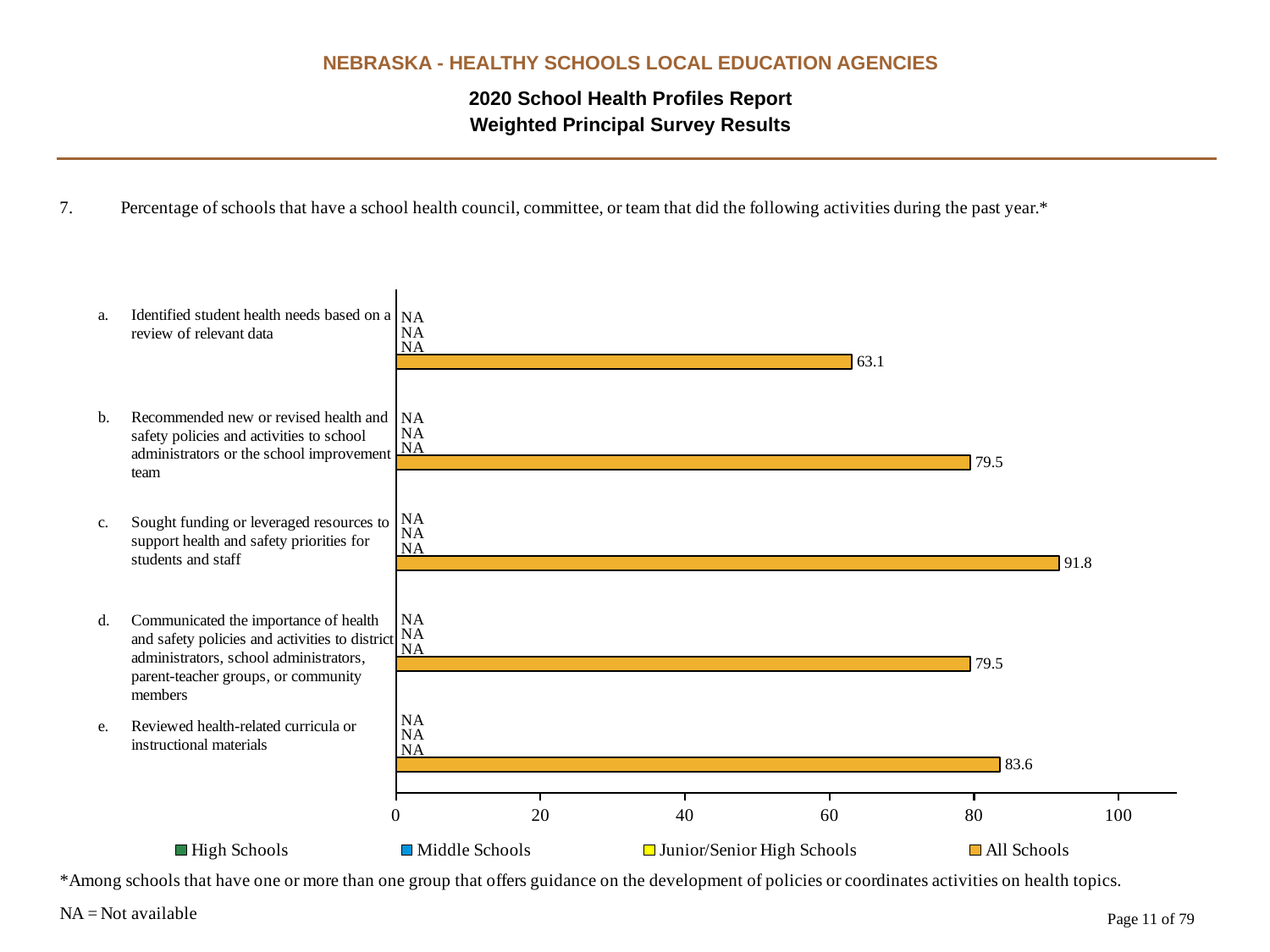
What is the All Schools value for 'Sought funding or leveraged resources to support health and safety priorities for students and staff'? 91.8 Which is larger for All Schools: 'Reviewed health-related curricula or instructional materials' or 'Recommended new or revised health and safety policies and activities to school administrators or the school improvement team'? Reviewed health-related curricula or instructional materials Which activity has the lowest All Schools percentage? Identified student health needs based on a review of relevant data What is the difference between the All Schools values for activity c (sought funding) and activity a (identified student health needs)? 28.7 What kind of chart is shown on the slide? Bar chart Which activity has the highest All Schools percentage? Sought funding or leveraged resources to support health and safety priorities for students and staff What is the All Schools value for 'Reviewed health-related curricula or instructional materials'? 83.6 What is the All Schools value for 'Identified student health needs based on a review of relevant data'? 63.1 How many activities (categories) are shown on the chart? 5 How many series does the legend list? 4 What is the All Schools value for 'Communicated the importance of health and safety policies and activities to district administrators, school administrators, parent-teacher groups, or community members'? 79.5 What value is shown for High Schools for 'Reviewed health-related curricula or instructional materials'? NA